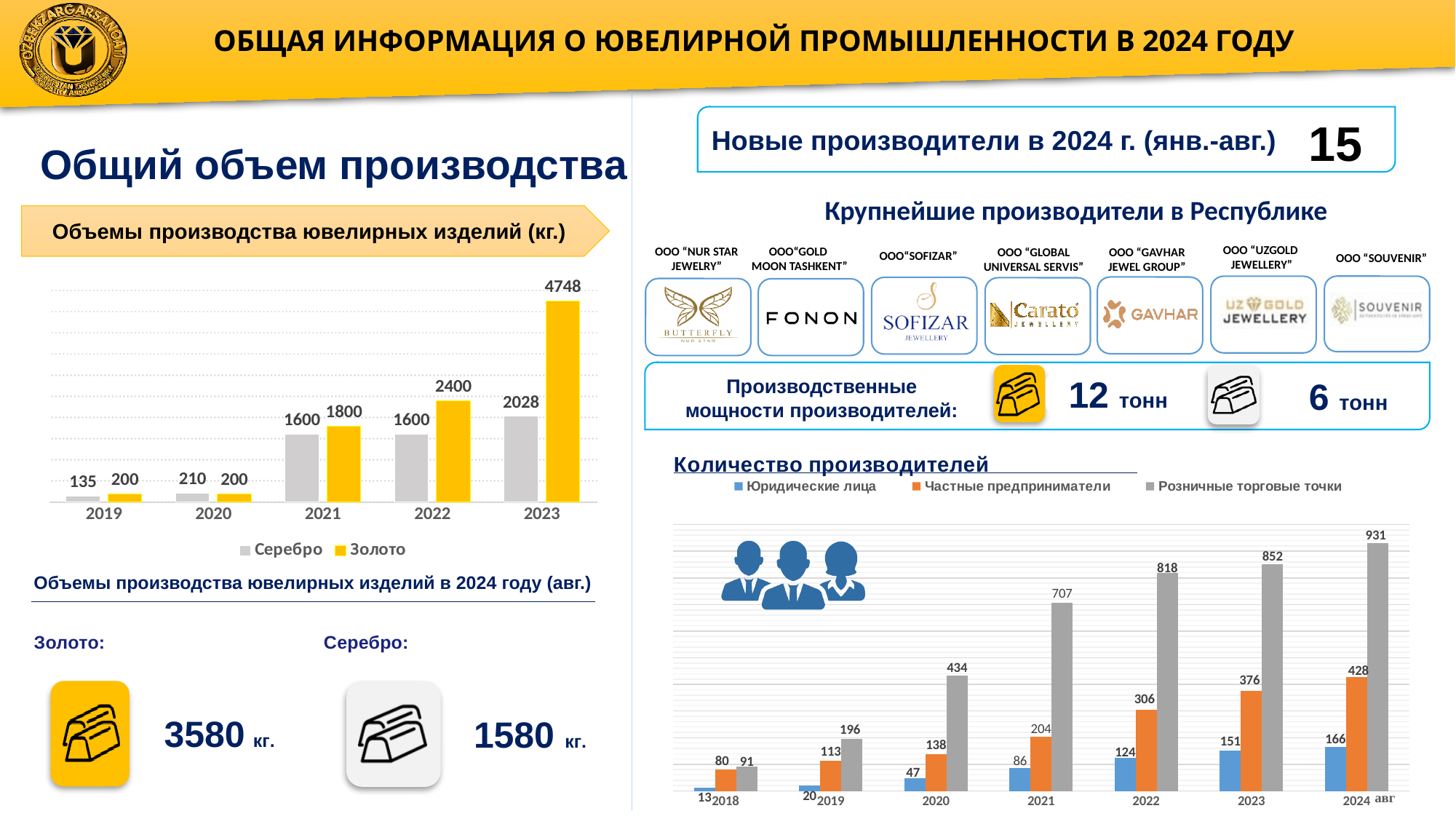
In the chart 'Количество производителей', what is the value for Розничные торговые точки in 2021? 707 In the chart 'Объемы производства ювелирных изделий (кг.)', how many years are shown on the x axis? 5 In the chart 'Объемы производства ювелирных изделий (кг.)', what is the value for Золото in 2023? 4748 In the chart 'Количество производителей', do the values for Частные предприниматели rise or fall from 2018 to 2024 авг? rise In the chart 'Объемы производства ювелирных изделий (кг.)', which year has the highest Золото value? 2023 In the chart 'Количество производителей', what is the difference between Розничные торговые точки in 2024 авг and in 2023? 79 In the chart 'Объемы производства ювелирных изделий (кг.)', what is the value for Серебро in 2020? 210 In the chart 'Количество производителей', which is larger in 2019: Частные предприниматели or Розничные торговые точки? Розничные торговые точки In the chart 'Объемы производства ювелирных изделий (кг.)', how many series does the legend list? 2 In the chart 'Объемы производства ювелирных изделий (кг.)', what is the difference between Золото and Серебро in 2022? 800 What kind of chart is 'Количество производителей'? bar chart In the chart 'Количество производителей', what is the value for Юридические лица in 2024 авг? 166